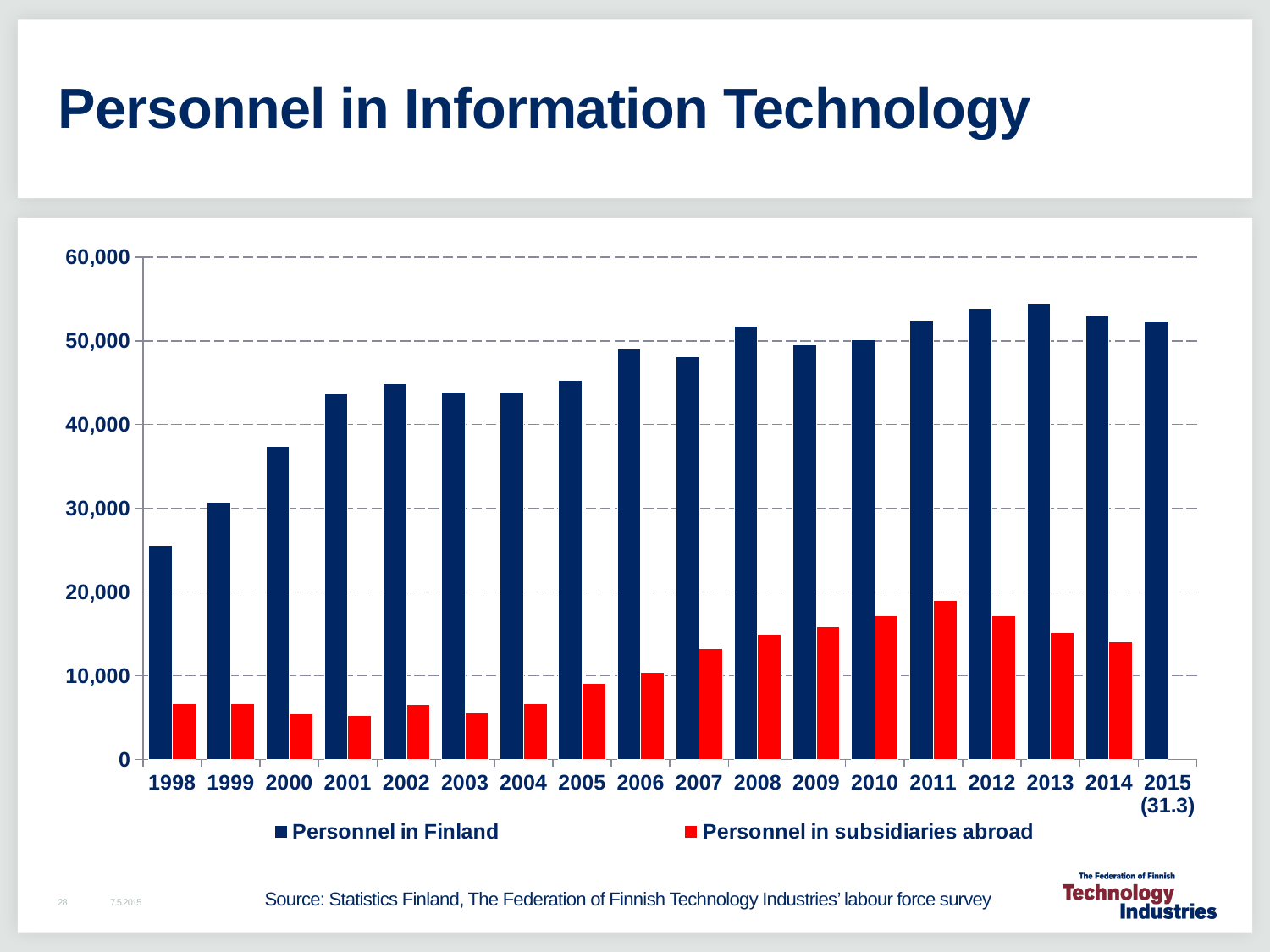
Does Personnel in Finland generally rise or fall from 1998 to 2013? rise How many years are shown on the x axis? 18 Which year has the lowest value for Personnel in Finland? 1998 Which year has the highest value for Personnel in subsidiaries abroad? 2011 What kind of chart is shown on the slide? bar chart Is the value for Personnel in subsidiaries abroad in 2011 greater or less than 20,000? less Is the value for Personnel in Finland in 1998 greater or less than 20,000? greater How many series does the legend list? 2 Is the value for Personnel in Finland in 2000 greater or less than 40,000? less Which year has the highest value for Personnel in Finland? 2013 Which is larger: Personnel in subsidiaries abroad in 2011 or in 2014? 2011